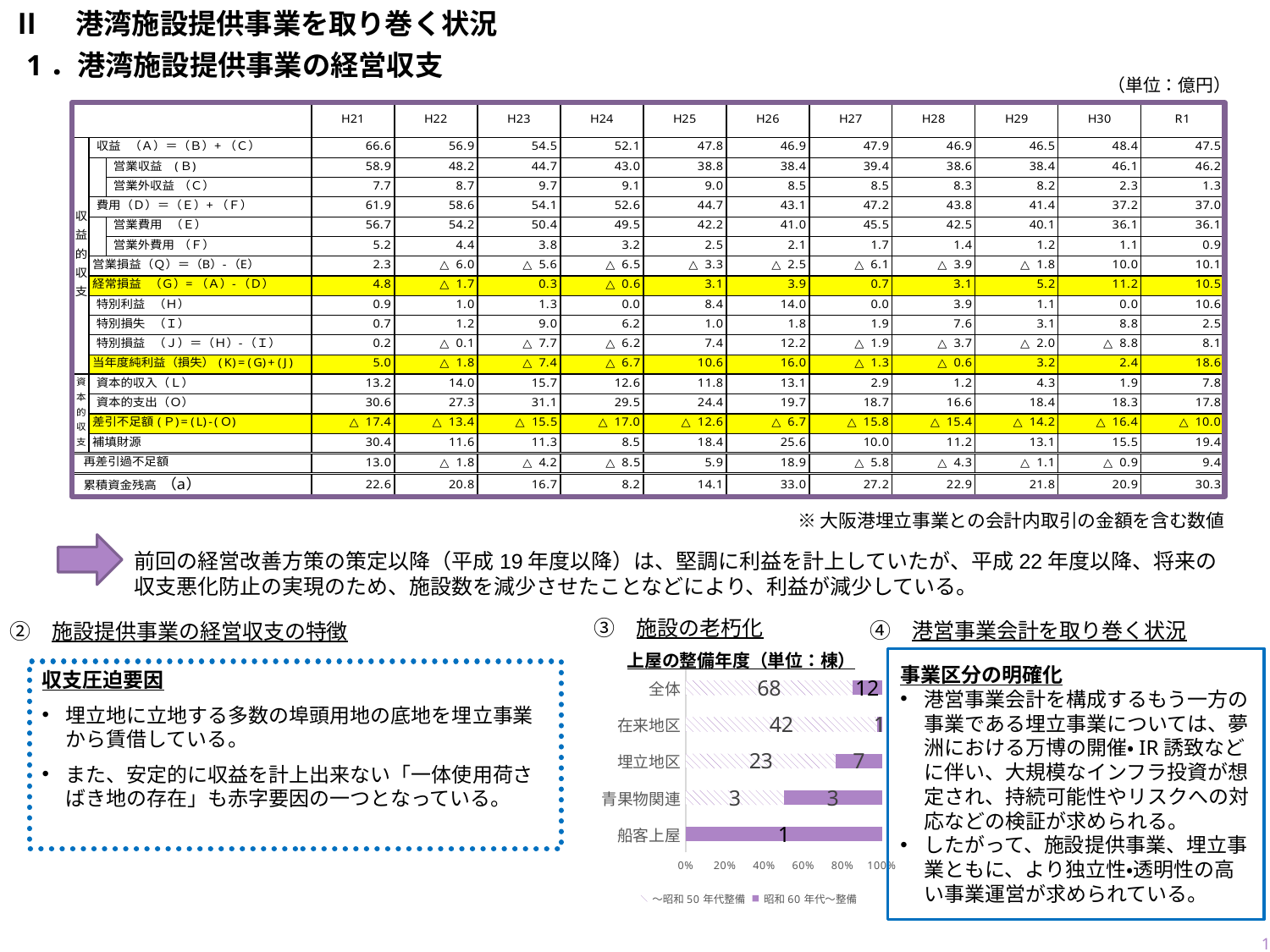
In the 上屋の整備年度 chart, what is the value of ～昭和50年代整備 for 青果物関連? 3 In the 上屋の整備年度 chart, which category has the highest ～昭和50年代整備 value? 全体 In the 上屋の整備年度 chart, how many series does the legend list? 2 In the 上屋の整備年度 chart, what is the value of 昭和60年代～整備 for 全体? 12 In the 上屋の整備年度 chart, how many categories are plotted on the vertical axis? 5 In the 上屋の整備年度 chart, what is the value of ～昭和50年代整備 for 全体? 68 What kind of chart is shown under the heading 上屋の整備年度（単位：棟）? bar chart In the 上屋の整備年度 chart, what is the difference between the ～昭和50年代整備 value and the 昭和60年代～整備 value for 全体? 56 In the 上屋の整備年度 chart, which is larger for 在来地区: the ～昭和50年代整備 value or the 昭和60年代～整備 value? ～昭和50年代整備 In the 上屋の整備年度 chart, what is the value of 昭和60年代～整備 for 埋立地区? 7 In the 上屋の整備年度 chart, what is the total of the two series for 埋立地区? 30 In the 上屋の整備年度 chart, what is the value of ～昭和50年代整備 for 在来地区? 42